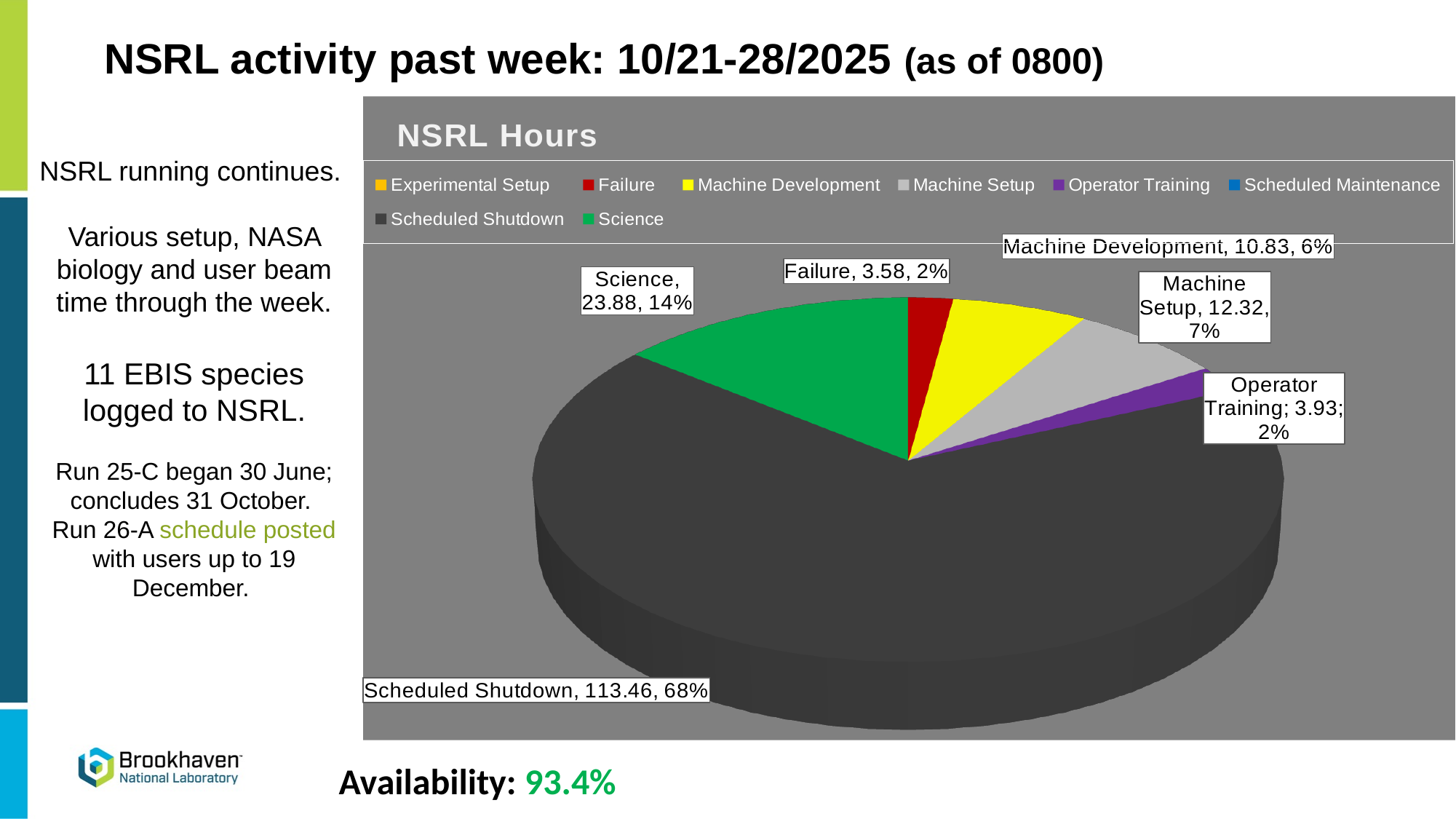
How many hours are labeled for Science? 23.88 What percentage share of the pie does Machine Development have? 6% Which category has the largest slice of the pie? Scheduled Shutdown Which has more hours, Machine Setup or Machine Development? Machine Setup How many hours are labeled for Machine Setup? 12.32 Which labeled category has the fewest hours? Failure What is the difference in hours between Science and Machine Development? 13.05 What percentage share of the pie does Scheduled Shutdown have? 68% How many hours are labeled for Scheduled Shutdown? 113.46 What is the title of the chart? NSRL Hours What type of chart is shown on the slide? pie chart How many entries does the chart legend list? 8